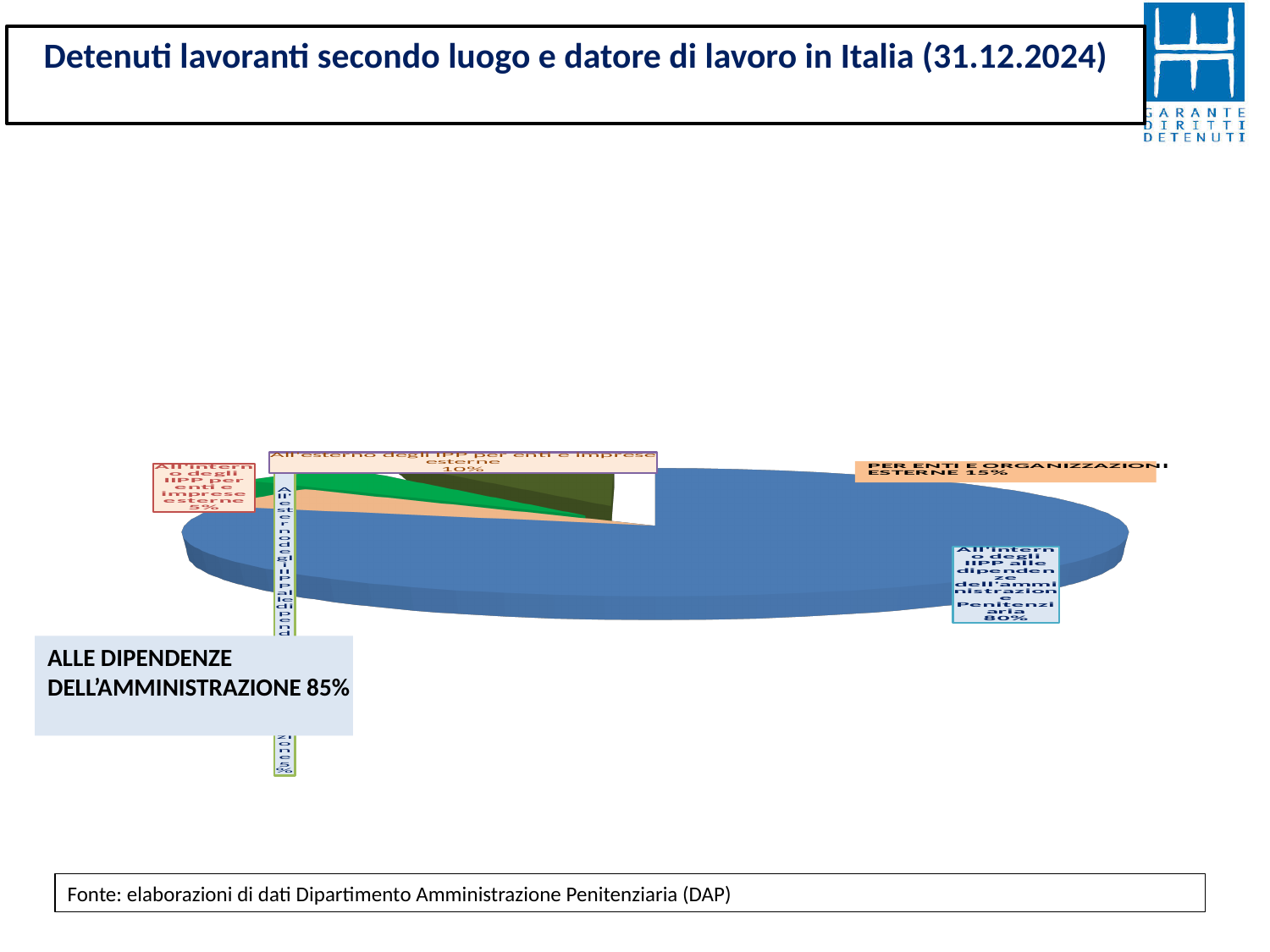
What is the title of the slide? Detenuti lavoranti secondo luogo e datore di lavoro in Italia (31.12.2024) What share of working detainees are inside the IIPP employed by the Penitentiary Administration (All'interno degli IIPP alle dipendenze dell'amministrazione Penitenziaria)? 80% Which is larger: the share outside the IIPP for external entities and companies, or the share inside the IIPP for external entities and companies? All'esterno degli IIPP per enti e imprese esterne How many slices does the pie chart have? 4 What share of working detainees are outside the IIPP for external entities and companies (All'esterno degli IIPP per enti e imprese esterne)? 10% What is the source of the data cited at the bottom of the slide? elaborazioni di dati Dipartimento Amministrazione Penitenziaria (DAP) What share of working detainees are inside the IIPP for external entities and companies (All'interno degli IIPP per enti e imprese esterne)? 5% According to the text box on the slide, what total share of working detainees work for external entities and organisations (PER ENTI E ORGANIZZAZIONI ESTERNE)? 15% What kind of chart is shown on the slide? pie chart Which category has the largest share of the pie? All'interno degli IIPP alle dipendenze dell'amministrazione Penitenziaria What is the difference in percentage points between the share inside the IIPP employed by the Penitentiary Administration (80%) and the share outside the IIPP for external entities and companies (10%)? 70 percentage points According to the text box on the slide, what total share of working detainees are employed by the Administration (ALLE DIPENDENZE DELL'AMMINISTRAZIONE)? 85%